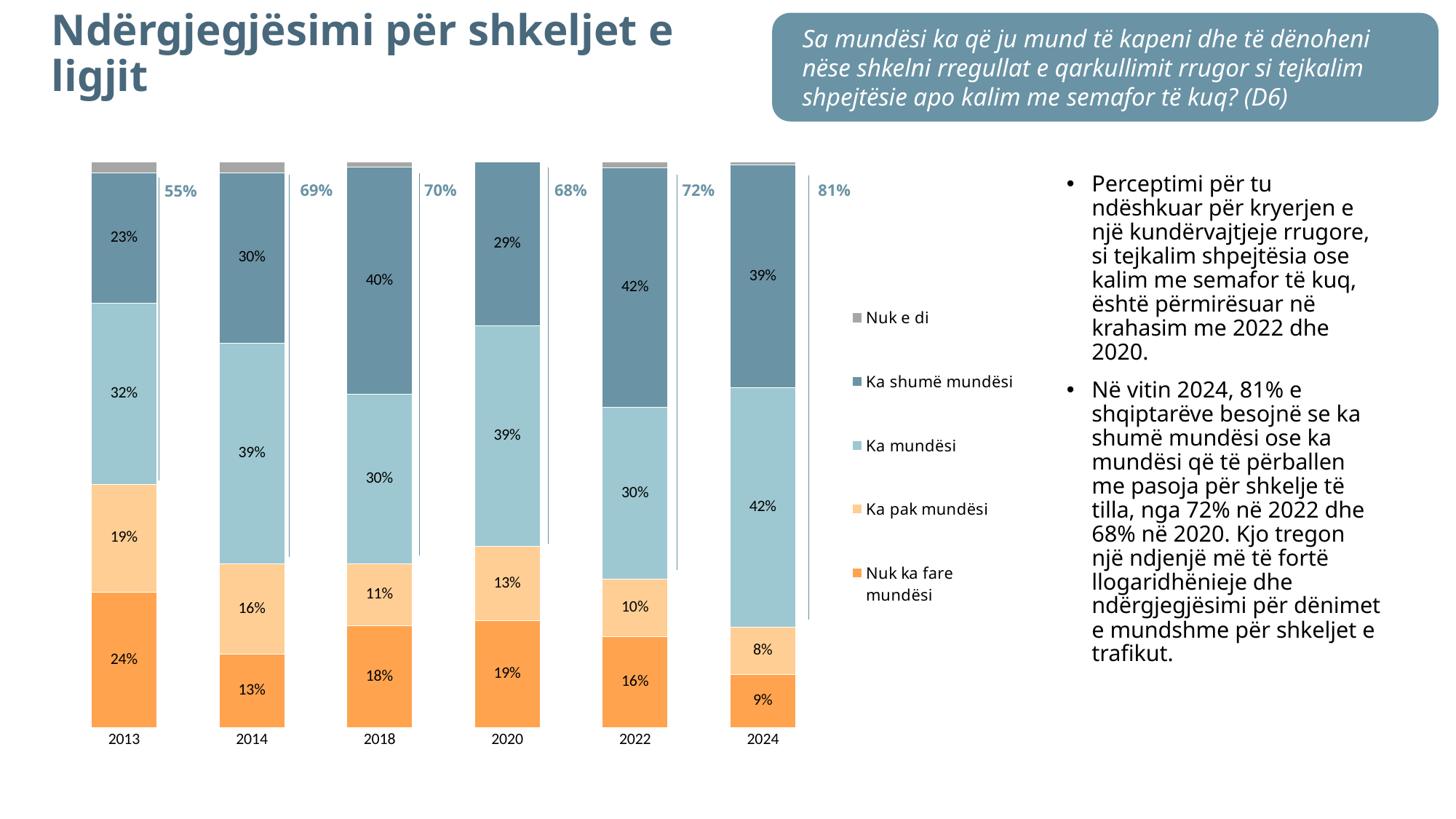
What combined percentage is printed above the 2024 bar for "Ka shumë mundësi" and "Ka mundësi" together? 81% How many years are shown on the x axis of the chart? 6 Which is larger: the "Ka pak mundësi" value in 2020 or in 2022? 2020 What is the value for "Nuk ka fare mundësi" in 2013? 24% What is the difference between the "Ka mundësi" values in 2014 and 2013? 7% How many series does the chart legend list? 5 What is the value for "Ka pak mundësi" in 2018? 11% In which year is the "Ka shumë mundësi" value the highest? 2022 What is the value for "Ka shumë mundësi" in 2022? 42% In which year is the "Nuk ka fare mundësi" value the lowest? 2024 What kind of chart is shown on the slide? Stacked bar chart What is the value for "Ka mundësi" in 2024? 42%